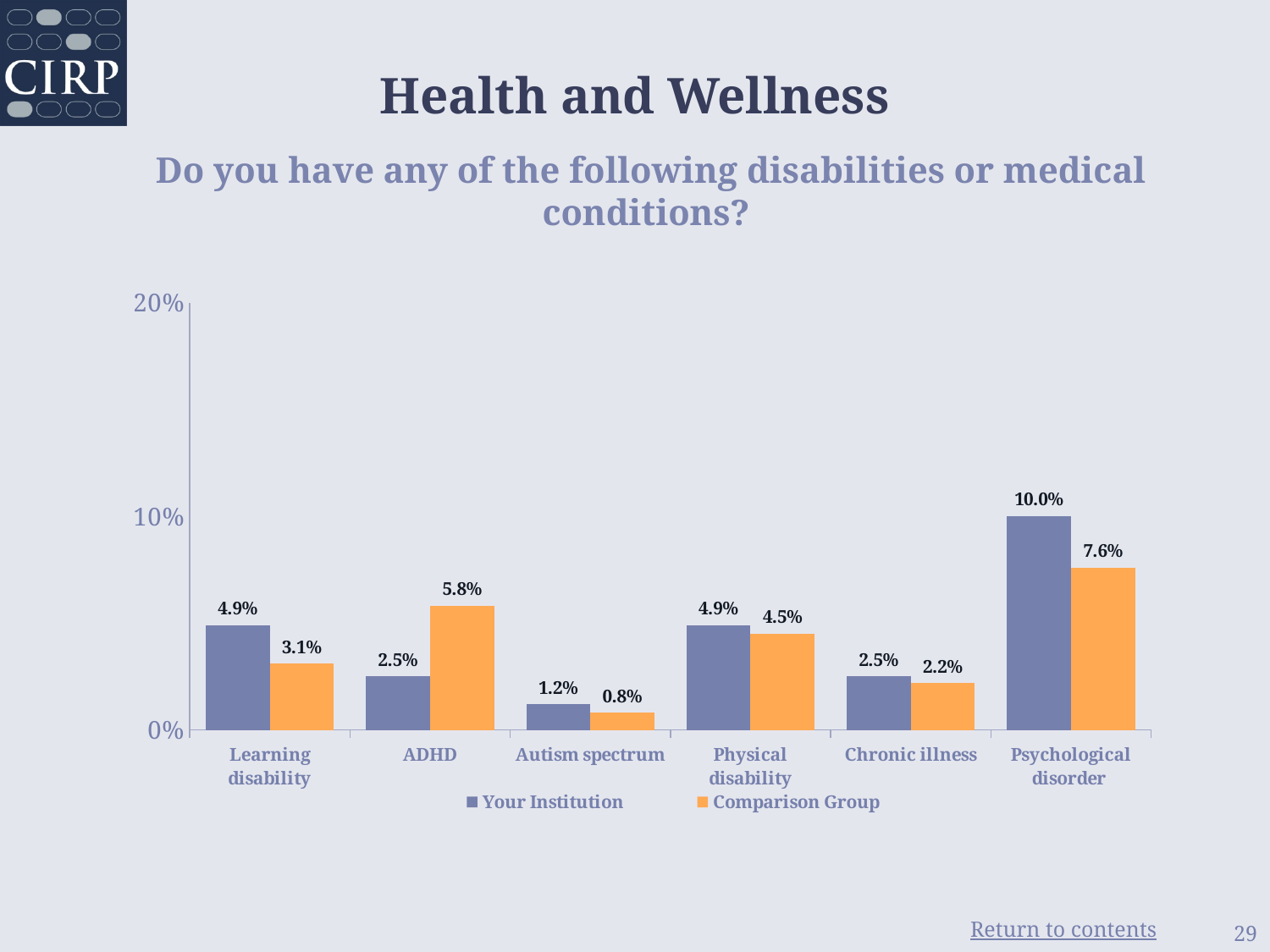
Is the value for Your Institution for Physical disability greater or less than 10%? less Which is larger for ADHD: Your Institution or Comparison Group? Comparison Group How many series does the legend list? 2 What kind of chart is shown on the slide? bar chart What is the value for Your Institution for Psychological disorder? 10.0% What is the difference between Your Institution and Comparison Group for Learning disability? 1.8% Which category has the highest value for Your Institution? Psychological disorder What is the value for Comparison Group for ADHD? 5.8% What is the difference between Your Institution and Comparison Group for Psychological disorder? 2.4% What is the value for Your Institution for Autism spectrum? 1.2% How many categories are shown on the x axis? 6 Which category has the lowest value for Comparison Group? Autism spectrum